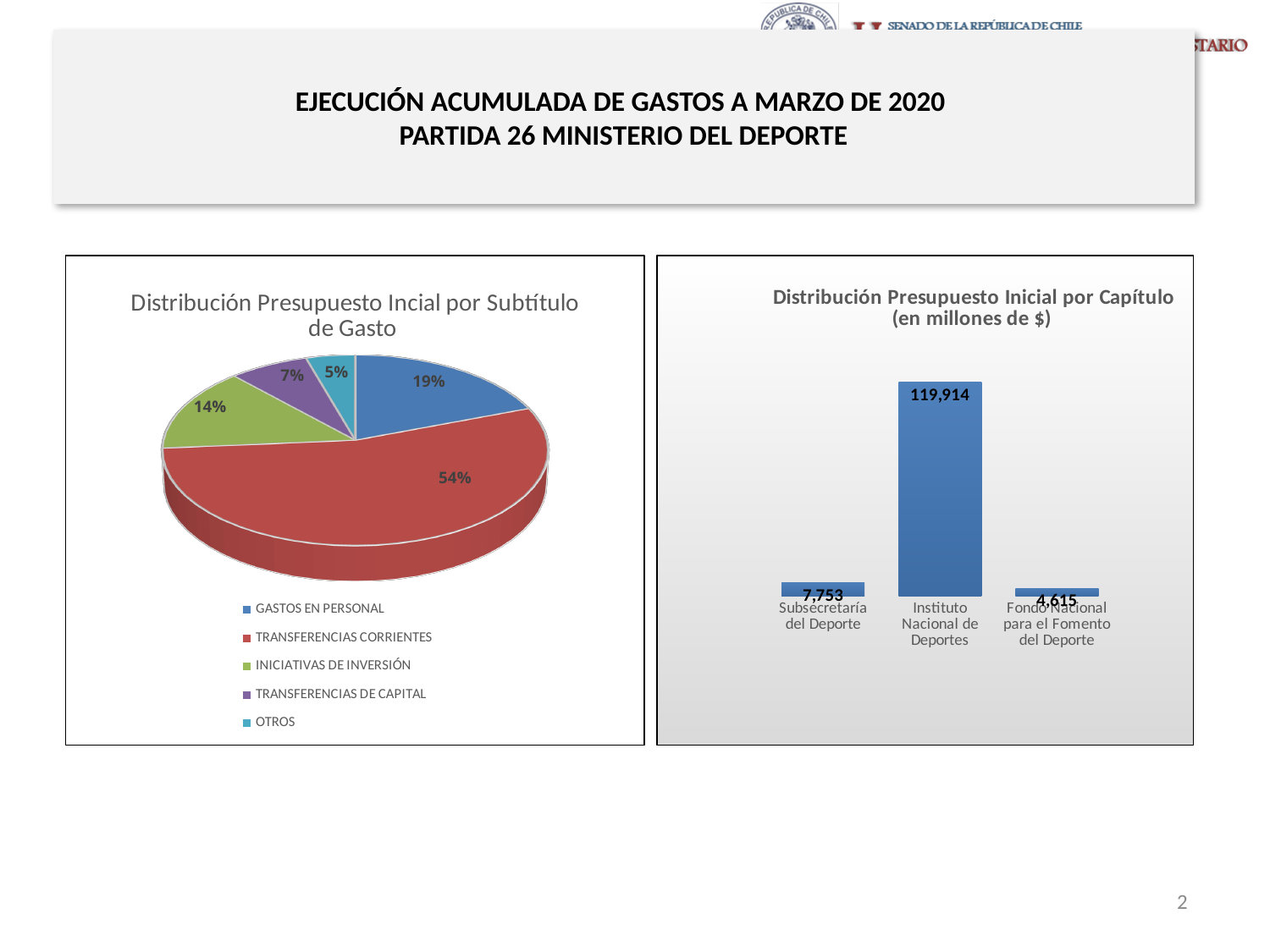
How many entries does the legend of the pie chart 'Distribución Presupuesto Incial por Subtítulo de Gasto' list? 5 In the chart 'Distribución Presupuesto Inicial por Capítulo (en millones de $)', which category has the lowest value? Fondo Nacional para el Fomento del Deporte In the chart 'Distribución Presupuesto Inicial por Capítulo (en millones de $)', what is the value for Instituto Nacional de Deportes? 119,914 In the pie chart 'Distribución Presupuesto Incial por Subtítulo de Gasto', what share does TRANSFERENCIAS CORRIENTES have? 54% In the chart 'Distribución Presupuesto Inicial por Capítulo (en millones de $)', what is the difference between the values for Subsecretaría del Deporte and Fondo Nacional para el Fomento del Deporte? 3,138 What kind of chart is 'Distribución Presupuesto Inicial por Capítulo (en millones de $)'? Bar chart In the chart 'Distribución Presupuesto Inicial por Capítulo (en millones de $)', what is the value for Fondo Nacional para el Fomento del Deporte? 4,615 In the chart 'Distribución Presupuesto Inicial por Capítulo (en millones de $)', how many categories are shown? 3 In the chart 'Distribución Presupuesto Inicial por Capítulo (en millones de $)', what is the value for Subsecretaría del Deporte? 7,753 In the pie chart 'Distribución Presupuesto Incial por Subtítulo de Gasto', which category has the smallest slice? OTROS In the chart 'Distribución Presupuesto Inicial por Capítulo (en millones de $)', which category has the highest value? Instituto Nacional de Deportes In the pie chart 'Distribución Presupuesto Incial por Subtítulo de Gasto', what share does GASTOS EN PERSONAL have? 19%